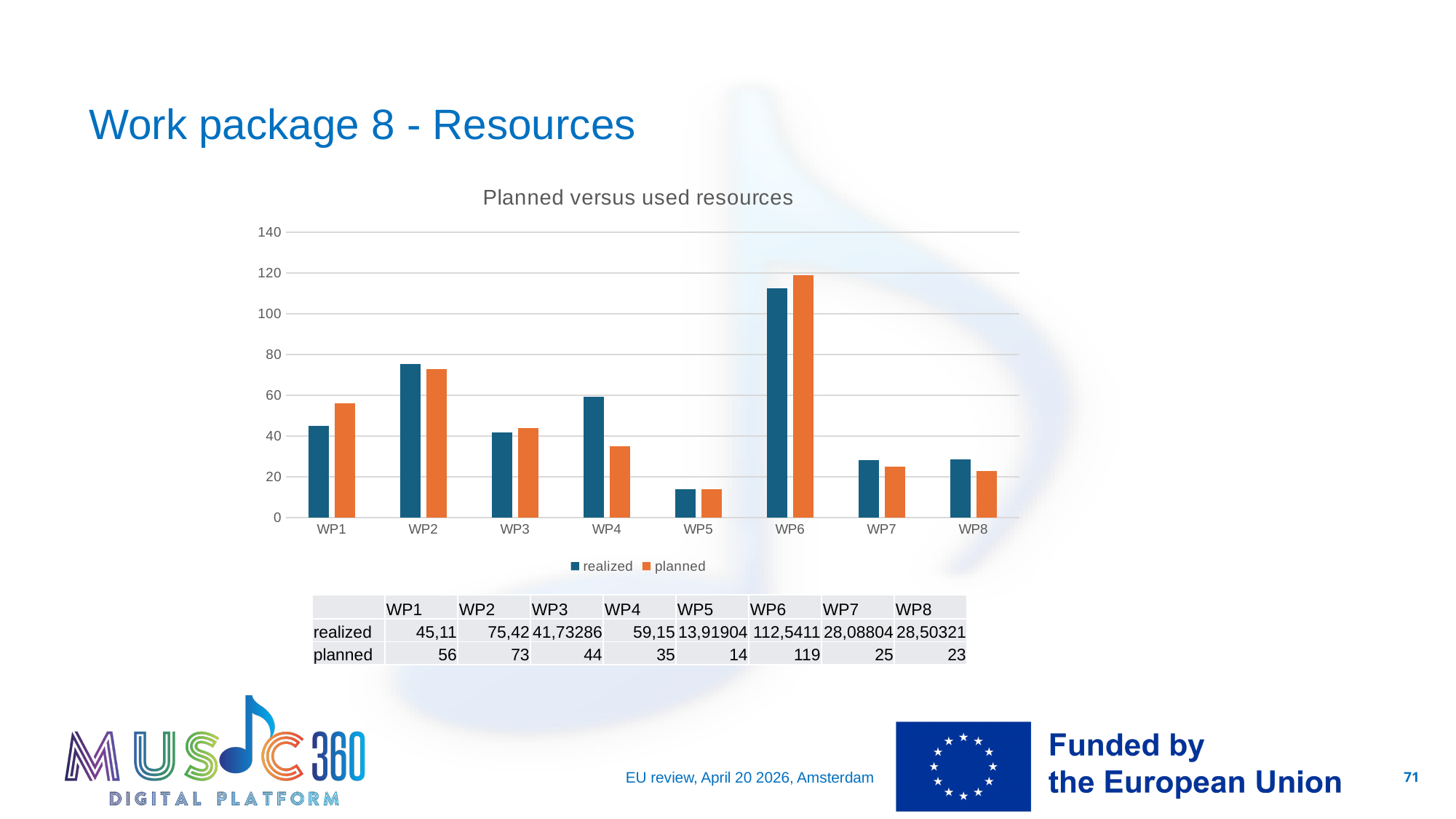
What is the realized value for WP1? 45,11 What is the title of the chart? Planned versus used resources How many work packages are shown on the x axis? 8 What kind of chart is shown? bar chart Is the realized value for WP6 greater or less than 100? greater How many series does the legend list? 2 What is the planned value for WP6? 119 For WP4, which is larger: the realized or the planned value? realized What is the planned value for WP4? 35 Which work package has the lowest realized value? WP5 Which work package has the highest planned value? WP6 What is the difference between the planned values for WP6 and WP1? 63